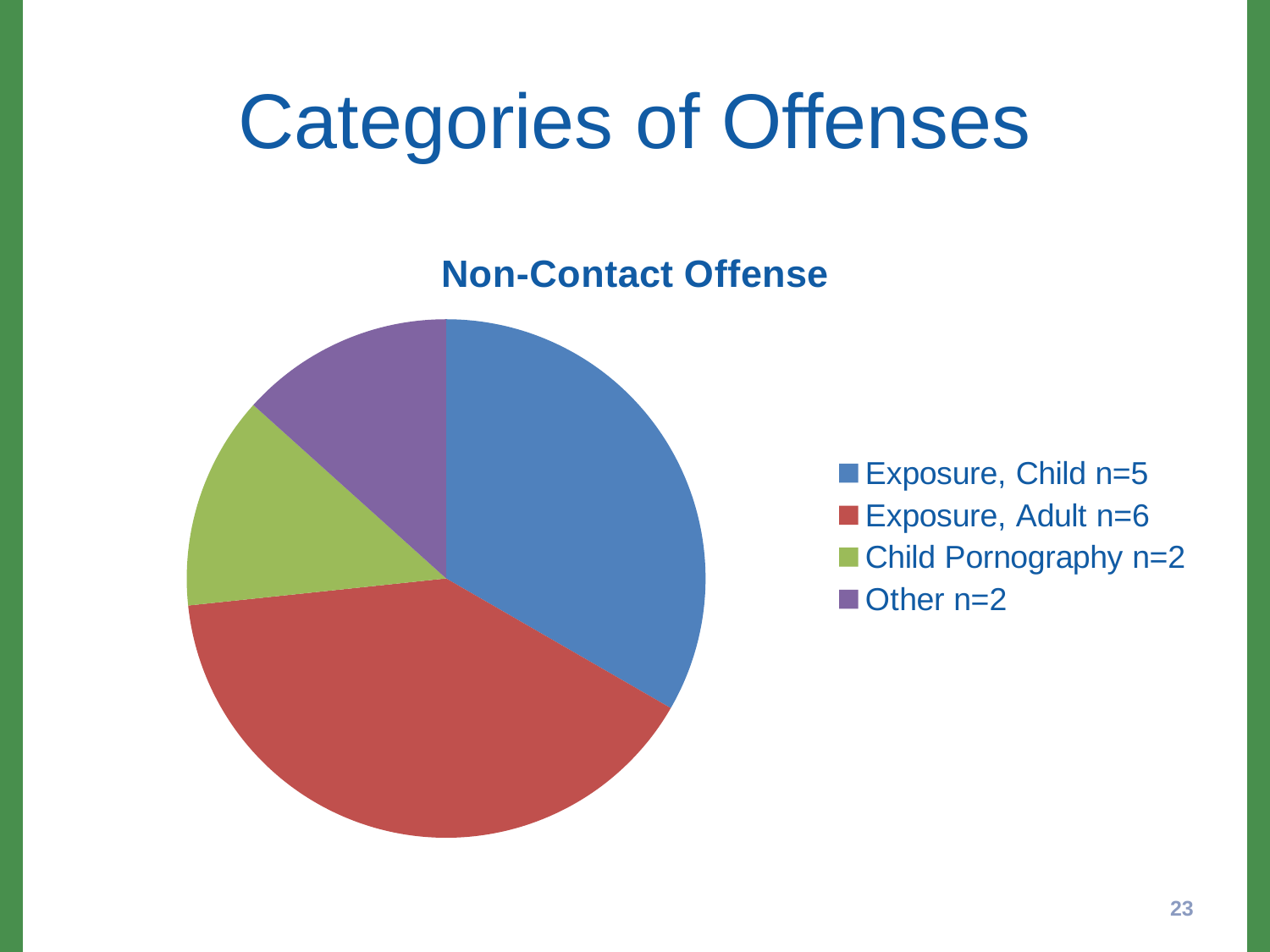
Which category has the largest slice of the pie? Exposure, Adult What colour represents Exposure, Child in the pie chart? Blue What is the n value for Other? n=2 What is the difference between the n values for Exposure, Child and Child Pornography? 3 How many categories does the pie chart show? 4 What type of chart is shown on the slide? Pie chart What is the n value for Exposure, Adult? n=6 What is the n value for Exposure, Child? n=5 What is the difference between the n values for Exposure, Adult and Exposure, Child? 1 What is the n value for Child Pornography? n=2 What is the title of the chart? Non-Contact Offense Which is larger, Exposure, Adult or Exposure, Child? Exposure, Adult